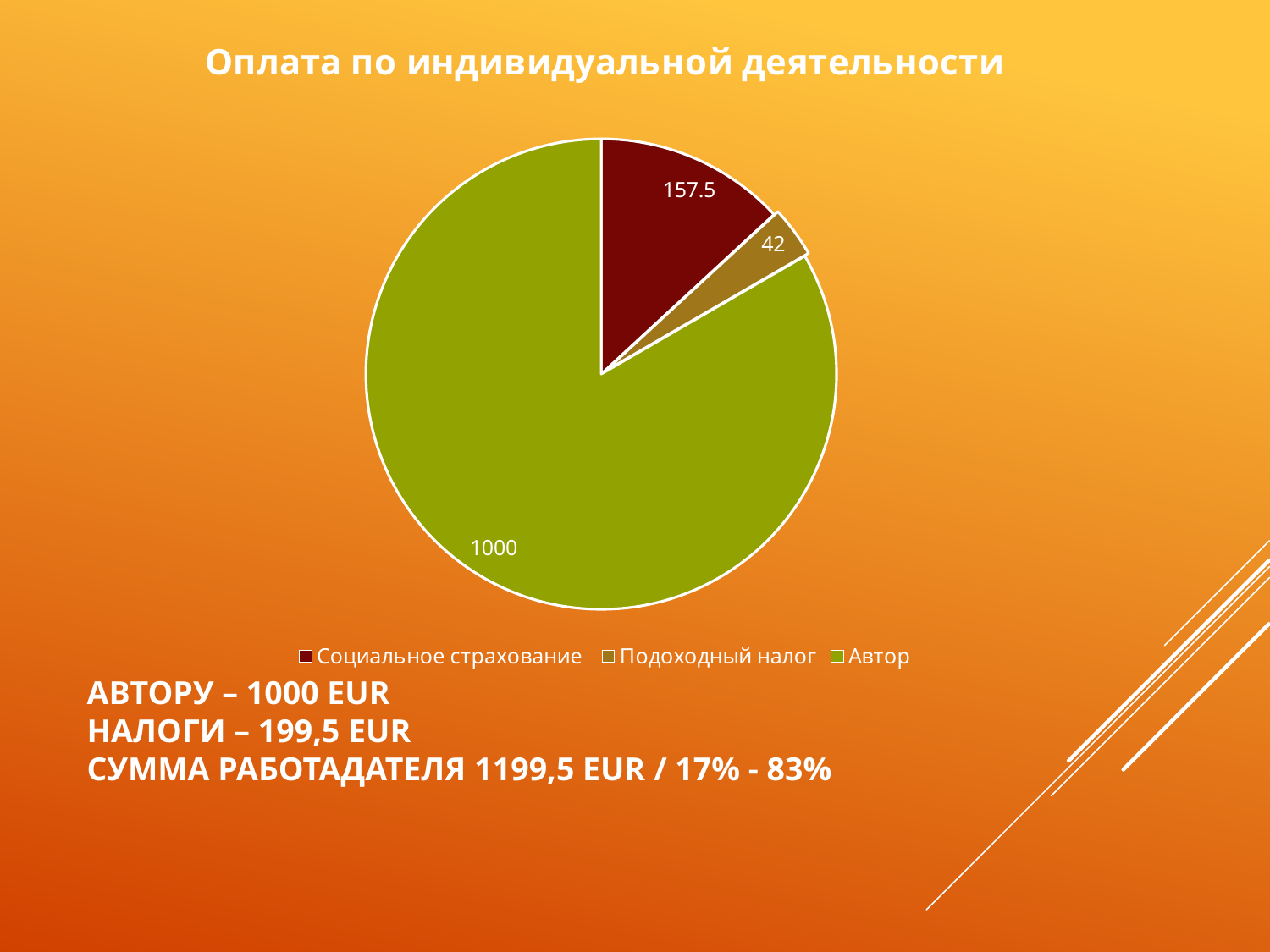
What is the total of all three slices? 1199.5 What is the title of the chart? Оплата по индивидуальной деятельности What is the value of the Подоходный налог slice? 42 What is the value of the Автор slice? 1000 How many entries does the legend list? 3 Which slice is the smallest? Подоходный налог What is the value of the Социальное страхование slice? 157.5 Which is larger, Социальное страхование or Подоходный налог? Социальное страхование How many slices does the pie chart have? 3 What is the difference between the Социальное страхование and Подоходный налог values? 115.5 What type of chart is shown on the slide? pie chart Which slice is the largest? Автор